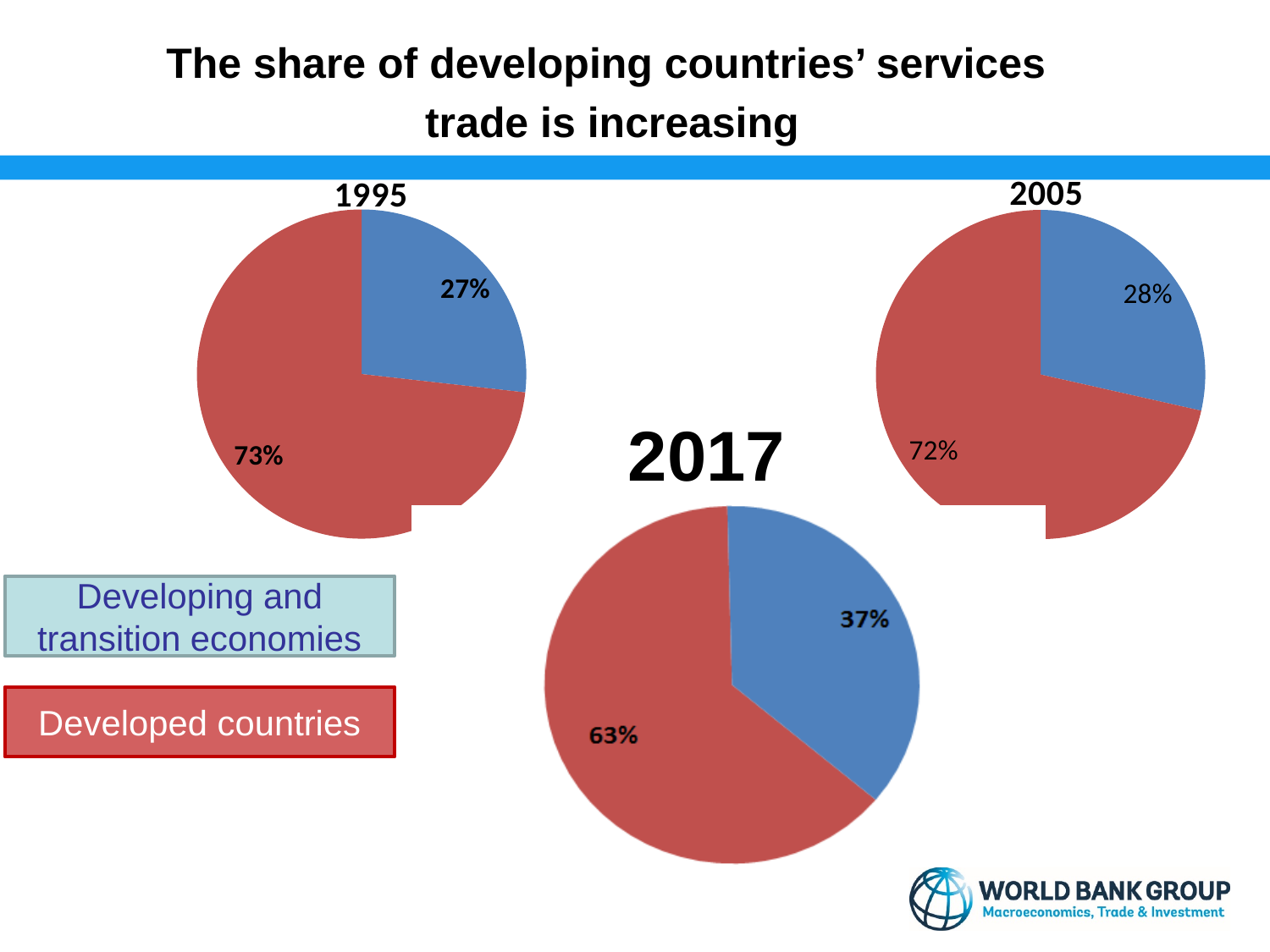
In the 2017 pie chart, what share is shown for developed countries? 63% In the 2017 pie chart, what share is shown for developing and transition economies? 37% In the 1995 pie chart, which group has the smaller share? Developing and transition economies In the 2005 pie chart, what share is shown for developed countries? 72% In the 1995 pie chart, what share is shown for developing and transition economies? 27% In the 2005 pie chart, what share is shown for developing and transition economies? 28% How many pie charts are shown on the slide? 3 In the 1995 pie chart, what share is shown for developed countries? 73% In the 2017 pie chart, which group has the larger share? Developed countries What is the difference between the developed countries' share in 1995 and in 2017? 10 percentage points Is the developing and transition economies' share larger in the 2005 pie chart or the 2017 pie chart? 2017 What type of chart is used on this slide? Pie chart